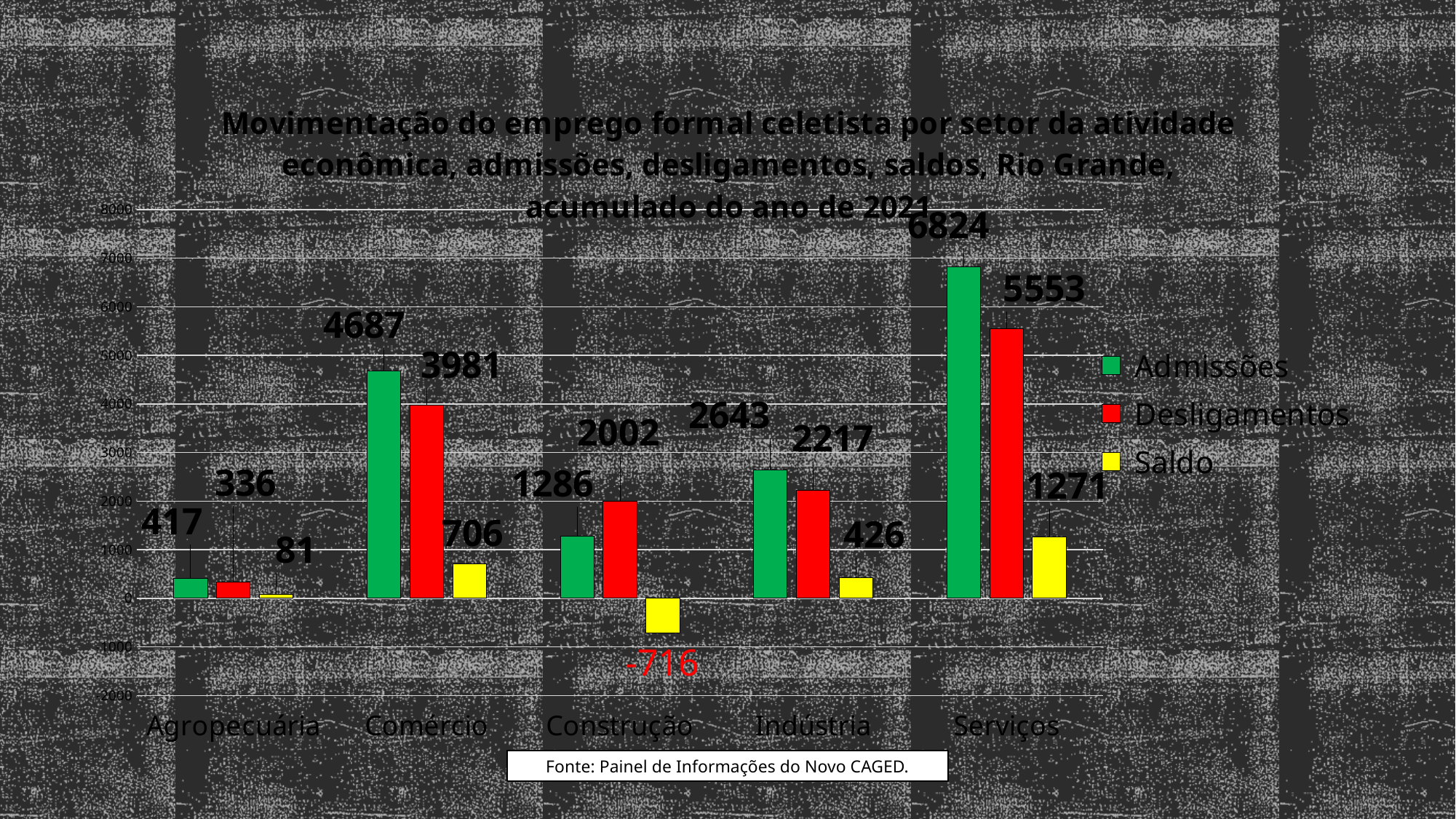
What is the value of Admissões for Comércio? 4687 What kind of chart is shown on the slide? bar chart What colour represents the Saldo series? yellow Which sector has the highest Admissões value? Serviços What is the Saldo value for Construção? -716 What is the difference between Admissões and Desligamentos for Indústria? 426 How many sectors are shown on the x axis? 5 What is the value of Desligamentos for Serviços? 5553 Which sector has the lowest Saldo value? Construção Is the Desligamentos value for Comércio greater or less than 3000? greater How many series does the legend list? 3 Which is larger for Agropecuária, Admissões or Desligamentos? Admissões